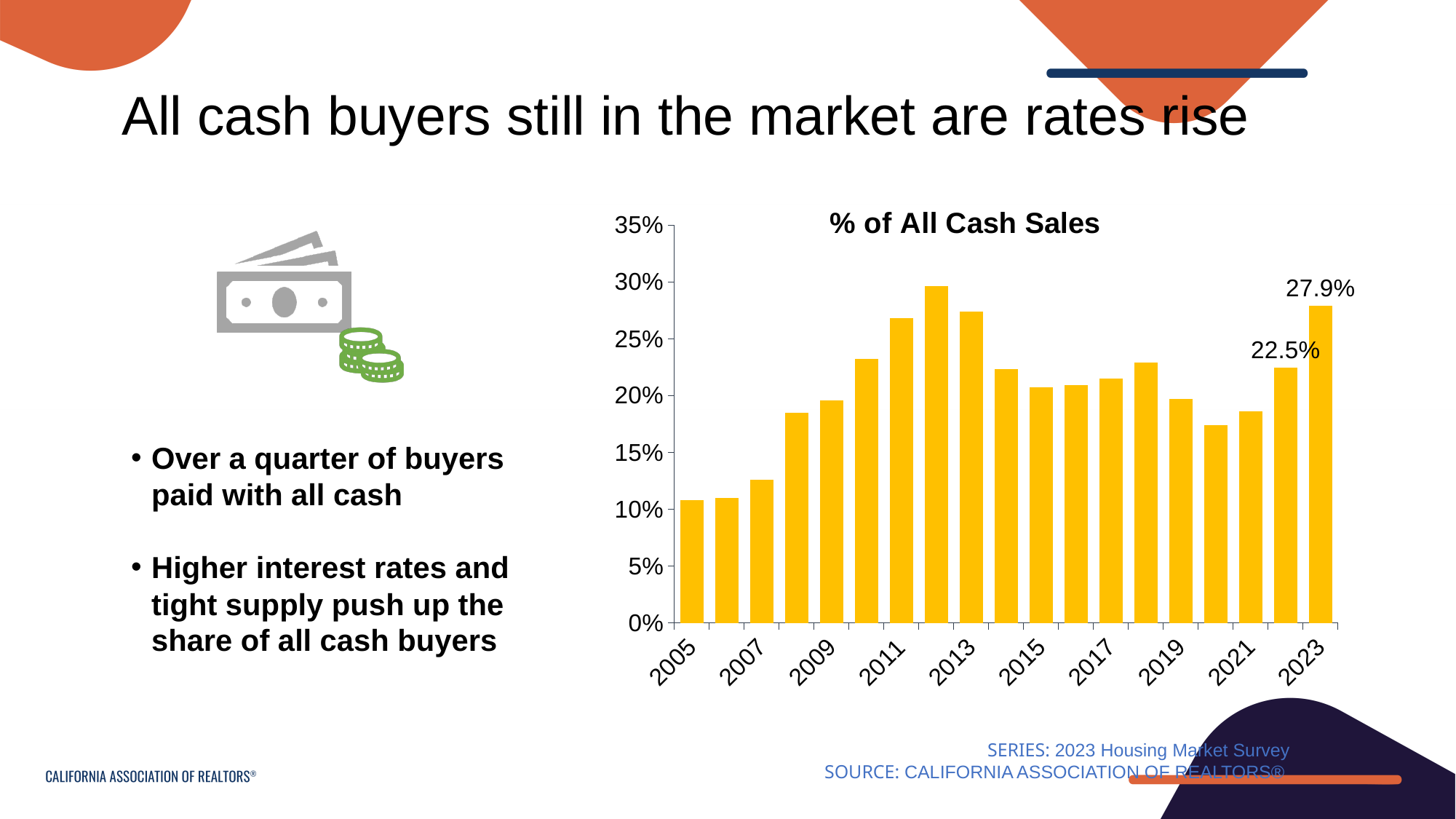
Is the value for 2020 in the % of All Cash Sales chart greater or less than 20%? less Do the values in the % of All Cash Sales chart rise or fall from 2005 to 2012? Rise Is the value for 2005 in the % of All Cash Sales chart greater or less than 15%? less Which is larger in the % of All Cash Sales chart, the value for 2011 or 2015? 2011 Is the value for 2012 in the % of All Cash Sales chart greater or less than 25%? greater What is the difference between the 2023 and 2022 values in the % of All Cash Sales chart? 5.4 percentage points How many years (bars) are shown in the % of All Cash Sales chart? 19 Which is larger in the % of All Cash Sales chart, the value for 2022 or 2023? 2023 What is the value for 2023 in the % of All Cash Sales chart? 27.9% What kind of chart is used to show % of All Cash Sales? Bar chart Which year has the highest % of All Cash Sales? 2012 What is the value for 2022 in the % of All Cash Sales chart? 22.5%